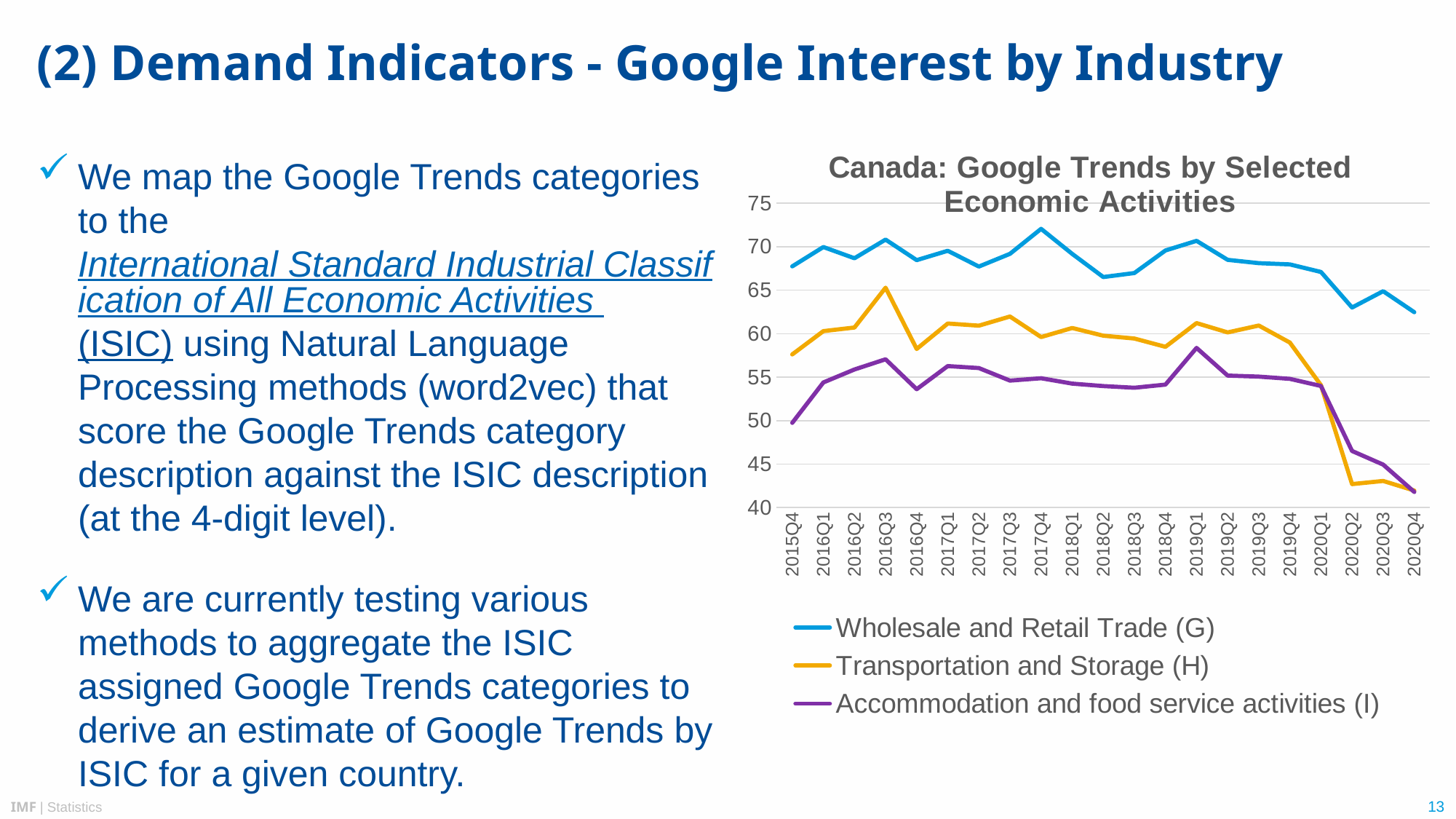
Which series is shown in purple in the chart? Accommodation and food service activities (I) Is the value for Accommodation and food service activities (I) in 2019Q1 greater or less than 55? greater Does the Transportation and Storage (H) series rise or fall from 2019Q3 to 2020Q2? Fall In 2018Q1, which is larger: Wholesale and Retail Trade (G) or Accommodation and food service activities (I)? Wholesale and Retail Trade (G) How many quarterly points are plotted along the x axis of the chart? 21 Which series has the highest value in 2020Q4? Wholesale and Retail Trade (G) Is the value for Wholesale and Retail Trade (G) in 2015Q4 greater or less than 65? greater What is the title of the chart? Canada: Google Trends by Selected Economic Activities Is the value for Wholesale and Retail Trade (G) in 2017Q4 greater or less than 70? greater What kind of chart is shown on the slide? Line chart How many series does the legend of the chart list? 3